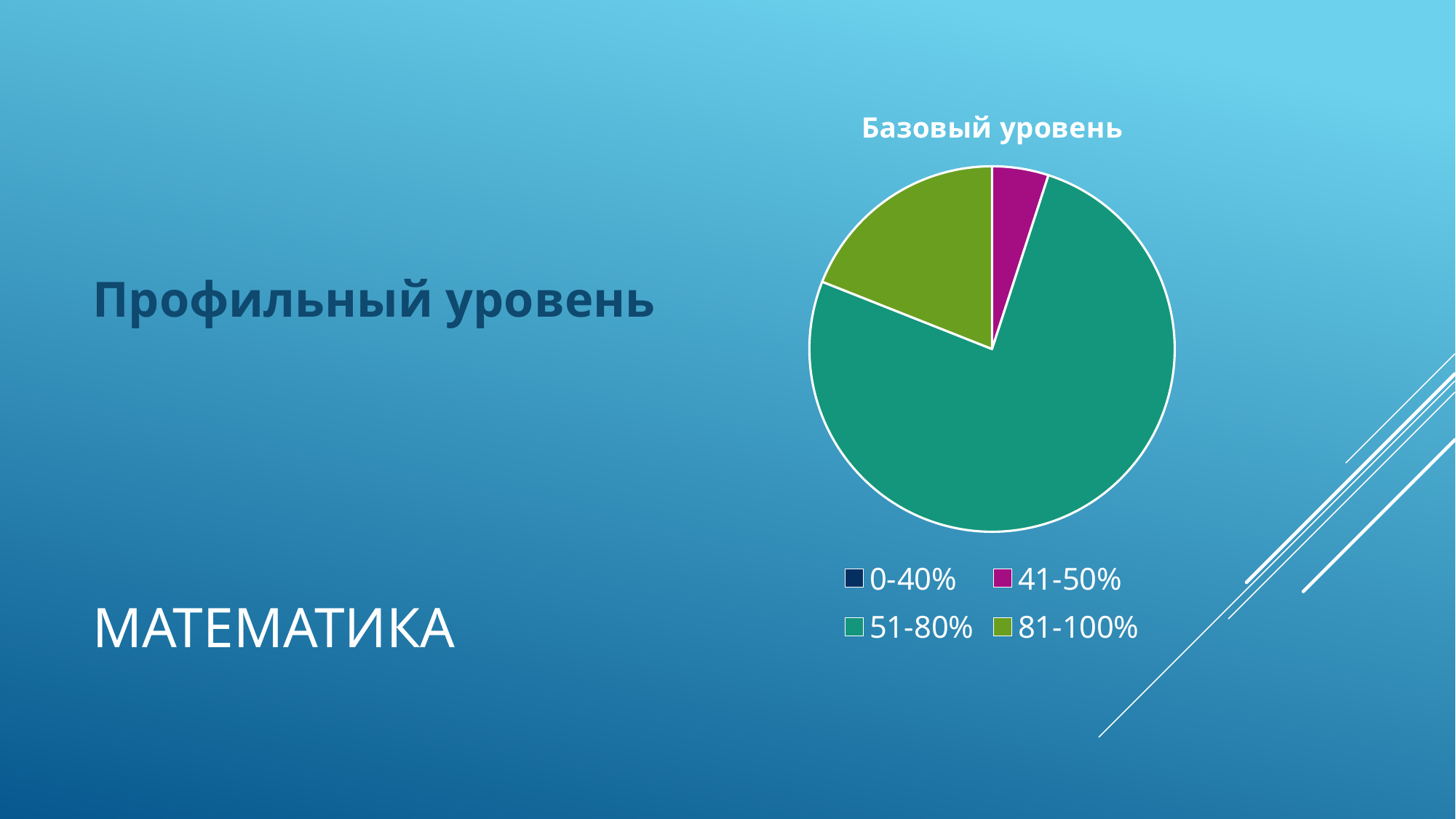
Which slice is larger in the pie chart, 41-50% or 81-100%? 81-100% Does the 51-80% slice take up more or less than half of the pie chart? more How many categories does the legend of the pie chart list? 4 What kind of chart is shown on the slide? pie chart Which category has the largest slice in the pie chart? 51-80% Which legend category is shown in green in the pie chart? 81-100% Which slice is larger in the pie chart, 51-80% or 81-100%? 51-80% Does the 81-100% slice take up more or less than half of the pie chart? less What is the title of the pie chart? Базовый уровень Which slice is smaller in the pie chart, 41-50% or 51-80%? 41-50%